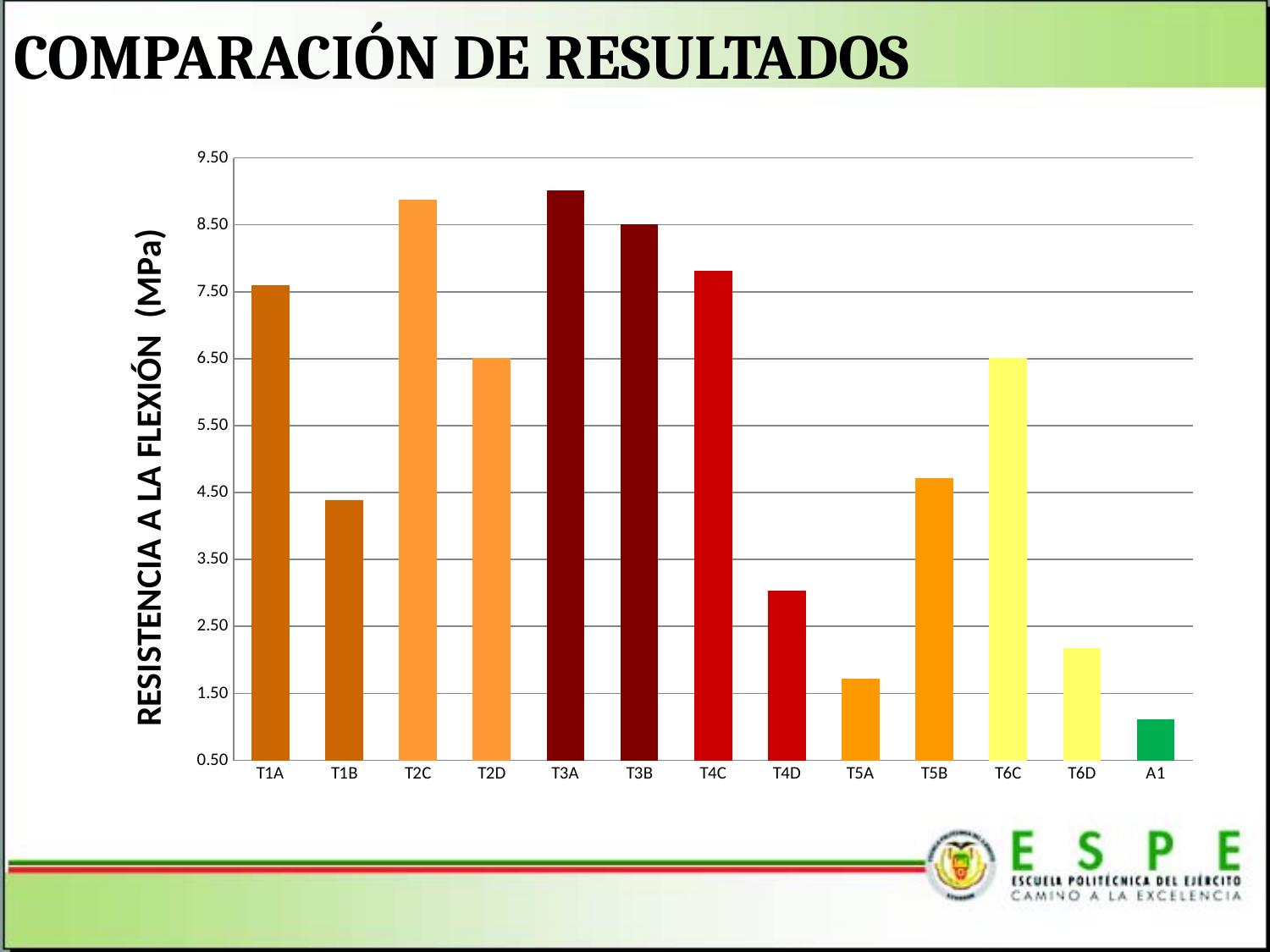
Is the value for T1B greater or less than 4.50? less What is the label of the vertical axis of the chart? RESISTENCIA A LA FLEXIÓN (MPa) Which category has the highest flexural strength in the chart? T3A Is the value for T1A greater or less than 7.50? greater What is the value for T3B in the chart? 8.50 Is the value for T6D greater or less than 2.50? less What is the value for T2D in the chart? 6.50 Which is larger, the value for T2C or the value for T4C? T2C What kind of chart is shown on the slide? bar chart Which category has the lowest flexural strength in the chart? A1 How many categories are shown on the x axis of the chart? 13